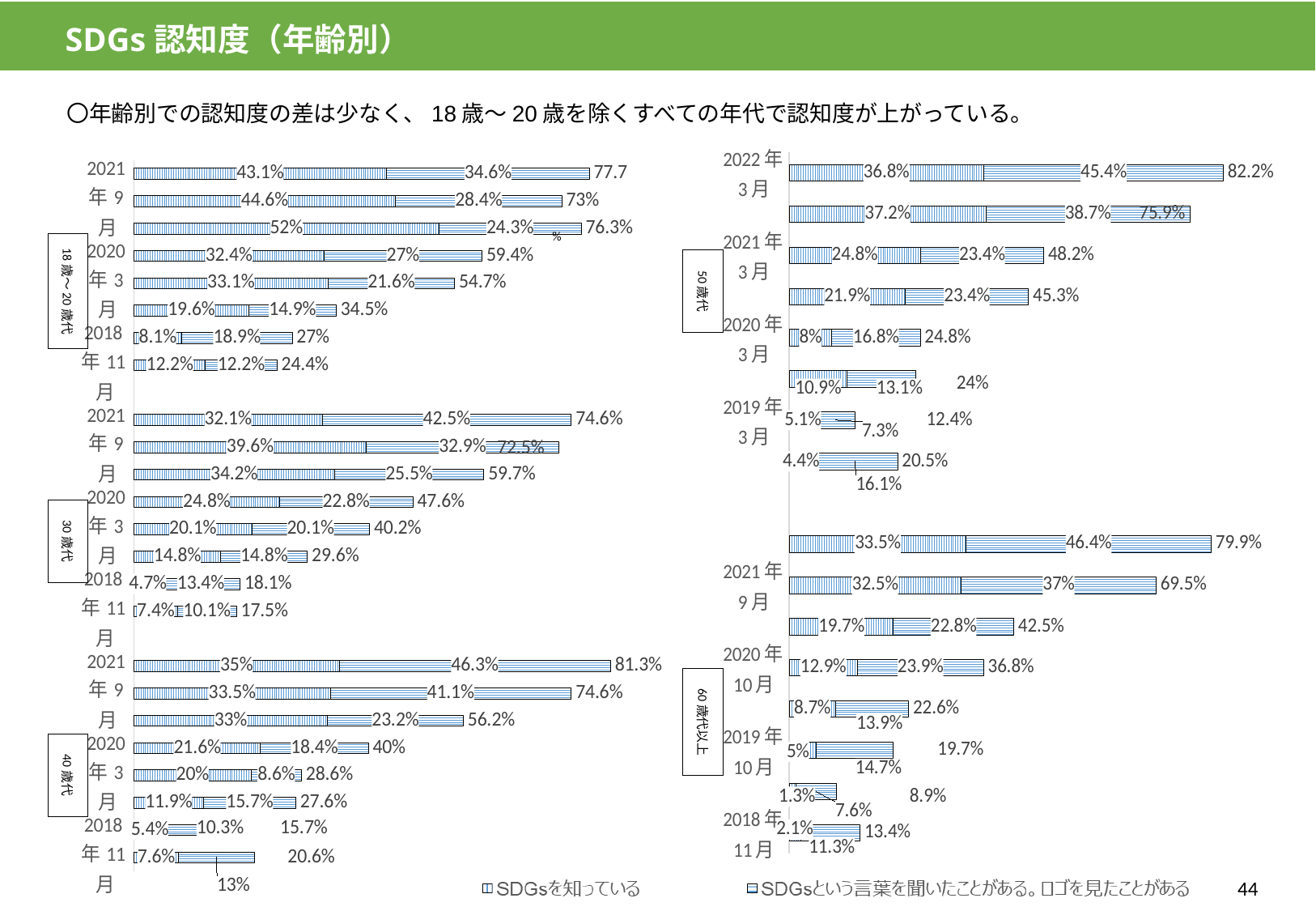
What is the title of the slide? SDGs 認知度（年齢別） In the left chart, what is the 'SDGsを知っている' value for the topmost bar of the 40歳代 group? 35% In the left chart, what is the total shown for the bottom bar (2018年11月) of the 18歳～20歳代 group? 24.4% In the left chart, what is the total shown for the topmost bar of the 40歳代 group? 81.3% How many series does the legend at the bottom of the slide list? 2 In the right chart, what is the 'SDGsという言葉を聞いたことがある。ロゴを見たことがある' value for the topmost bar of the 60歳代以上 group? 46.4% In the right chart, which is larger: the total of the topmost bar of the 50歳代 group or the total of the topmost bar of the 60歳代以上 group? 50歳代 (82.2%) In the left chart, what is the total shown for the topmost bar of the 18歳～20歳代 group? 77.7 In the right chart, what is the total shown for the topmost bar (2022年3月) of the 50歳代 group? 82.2% What type of chart is used on the left side of the slide? bar chart In the right chart, what is the total shown for the topmost bar of the 60歳代以上 group? 79.9% In the left chart, what is the difference between the totals of the topmost bars of the 40歳代 group (81.3%) and the 30歳代 group (74.6%)? 6.7%